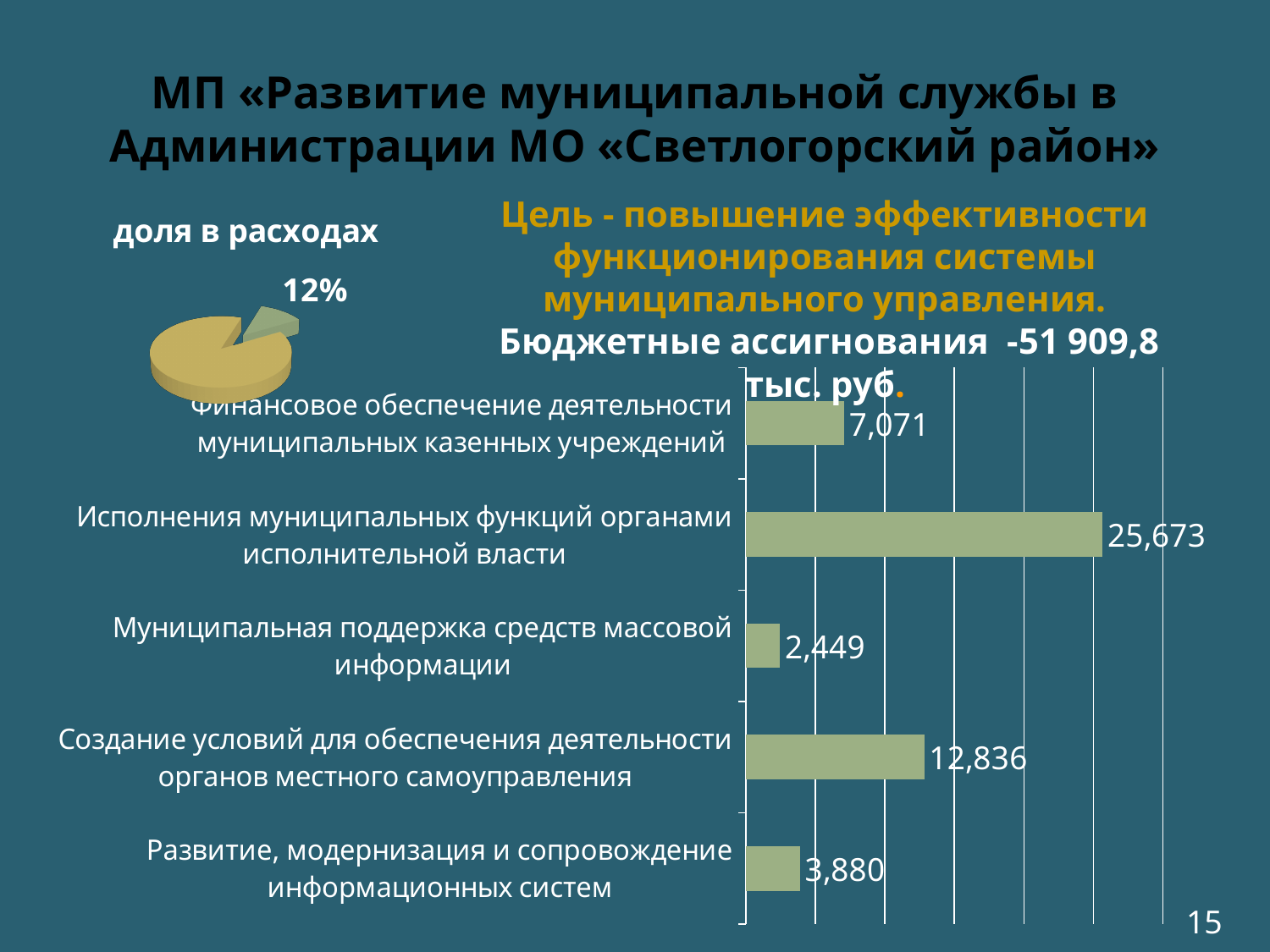
In the bar chart, what is the value for «Создание условий для обеспечения деятельности органов местного самоуправления»? 12,836 In the bar chart, which is larger: the value for «Финансовое обеспечение деятельности муниципальных казенных учреждений» or for «Развитие, модернизация и сопровождение информационных систем»? Финансовое обеспечение деятельности муниципальных казенных учреждений In the bar chart, which category has the lowest value? Муниципальная поддержка средств массовой информации In the bar chart, what is the value for «Развитие, модернизация и сопровождение информационных систем»? 3,880 In the bar chart, what is the value for «Муниципальная поддержка средств массовой информации»? 2,449 In the bar chart, what is the difference between the values for «Финансовое обеспечение деятельности муниципальных казенных учреждений» and «Развитие, модернизация и сопровождение информационных систем»? 3,191 In the bar chart, what is the difference between the values for «Исполнения муниципальных функций органами исполнительной власти» and «Создание условий для обеспечения деятельности органов местного самоуправления»? 12,837 What kind of chart is the chart on the right side of the slide? Bar chart In the bar chart, what is the value for «Исполнения муниципальных функций органами исполнительной власти»? 25,673 In the bar chart, which category has the highest value? Исполнения муниципальных функций органами исполнительной власти How many categories are shown in the bar chart? 5 In the pie chart «доля в расходах», what share is shown for the highlighted slice? 12%